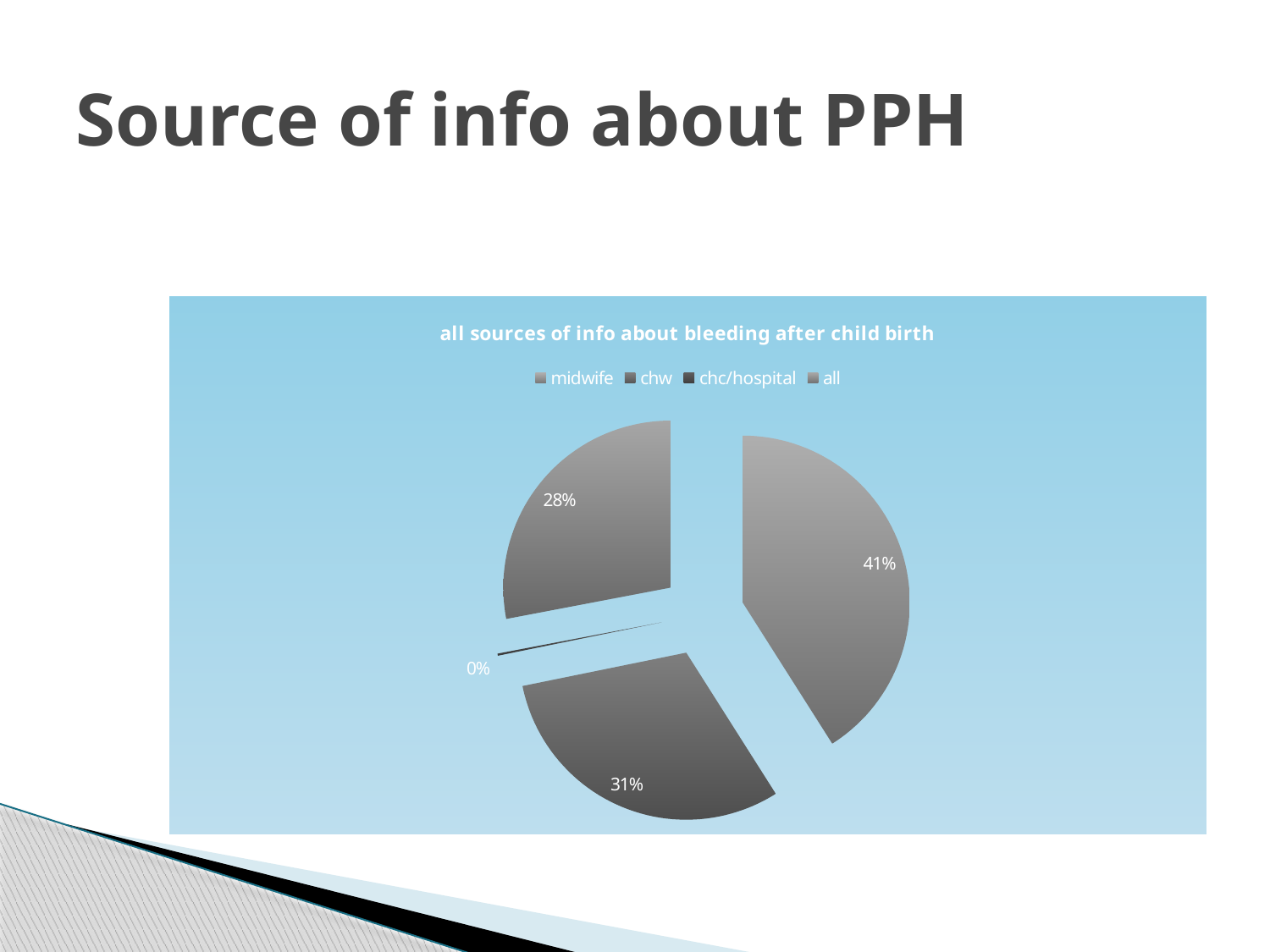
Is the largest slice of the pie greater or less than 50%? less What kind of chart is shown on the slide? pie chart What is the percentage shown on the largest slice of the pie? 41% What is the title of the chart? all sources of info about bleeding after child birth How many slices have a percentage label printed on the pie? 4 What is the difference in percentage points between the slices labelled 31% and 28%? 3 What are the four categories listed in the chart legend? midwife, chw, chc/hospital, all How many entries does the chart legend list? 4 What is the percentage shown on the smallest slice of the pie? 0% What is the combined share of the slices labelled 41% and 31%? 72% What is the difference in percentage points between the largest slice (41%) and the slice labelled 31%? 10 Which is larger: the slice labelled 28% or the slice labelled 41%? 41%